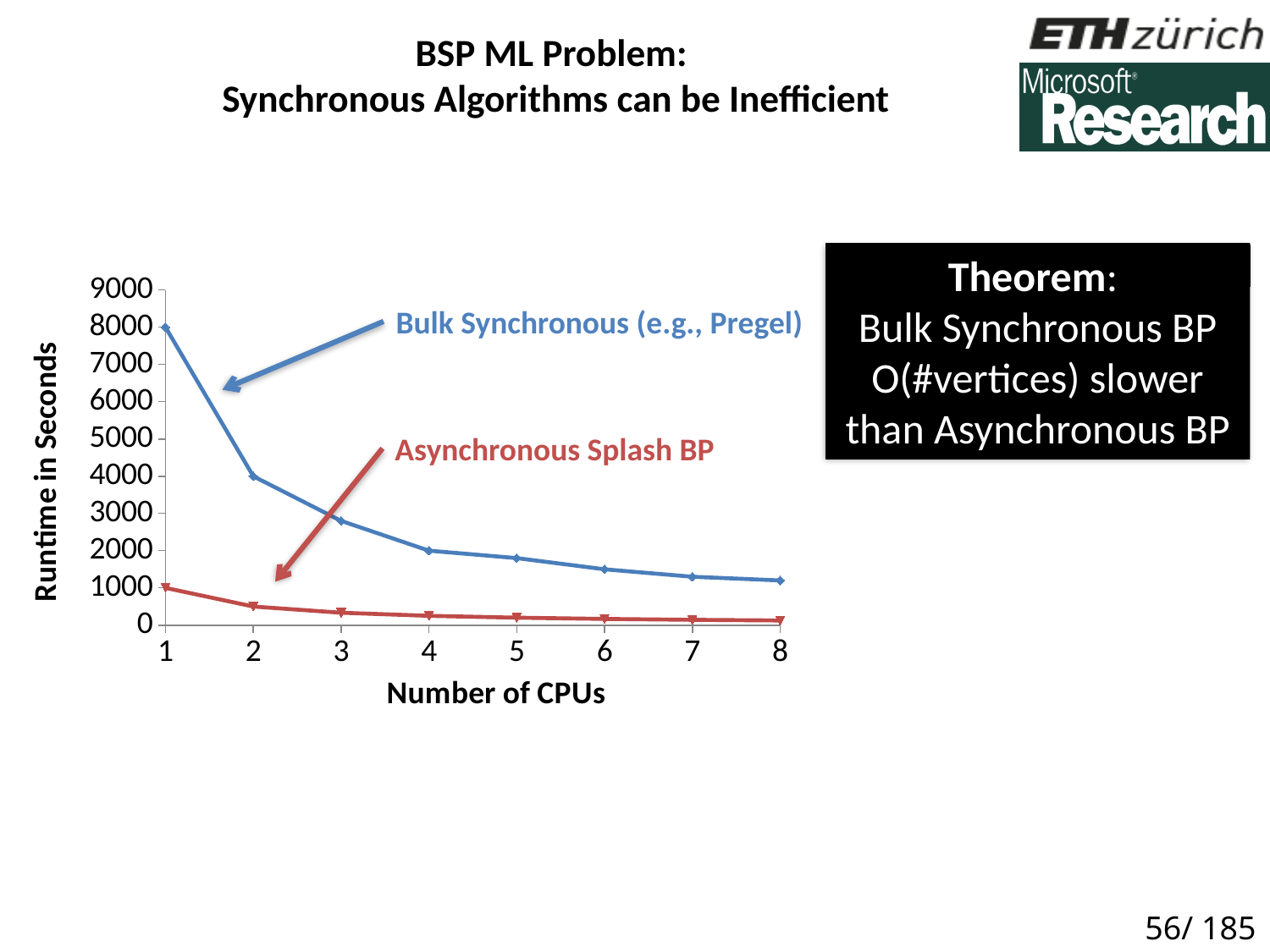
At which number of CPUs is the runtime for Bulk Synchronous (e.g., Pregel) highest? 1 Is the runtime for Asynchronous Splash BP at 1 CPU greater or less than 2000? less What is the title of the y axis? Runtime in Seconds What kind of chart is shown on the slide? line chart Does the runtime for Bulk Synchronous (e.g., Pregel) rise or fall as the number of CPUs increases? fall How many CPU counts are plotted along the x axis? 8 What is the title of the x axis? Number of CPUs Is the runtime for Bulk Synchronous (e.g., Pregel) at 8 CPUs greater or less than 2000? less Is the runtime for Bulk Synchronous (e.g., Pregel) at 2 CPUs greater or less than 3000? greater At 2 CPUs, which series has the larger runtime, Bulk Synchronous (e.g., Pregel) or Asynchronous Splash BP? Bulk Synchronous (e.g., Pregel) How many series are plotted on the chart? 2